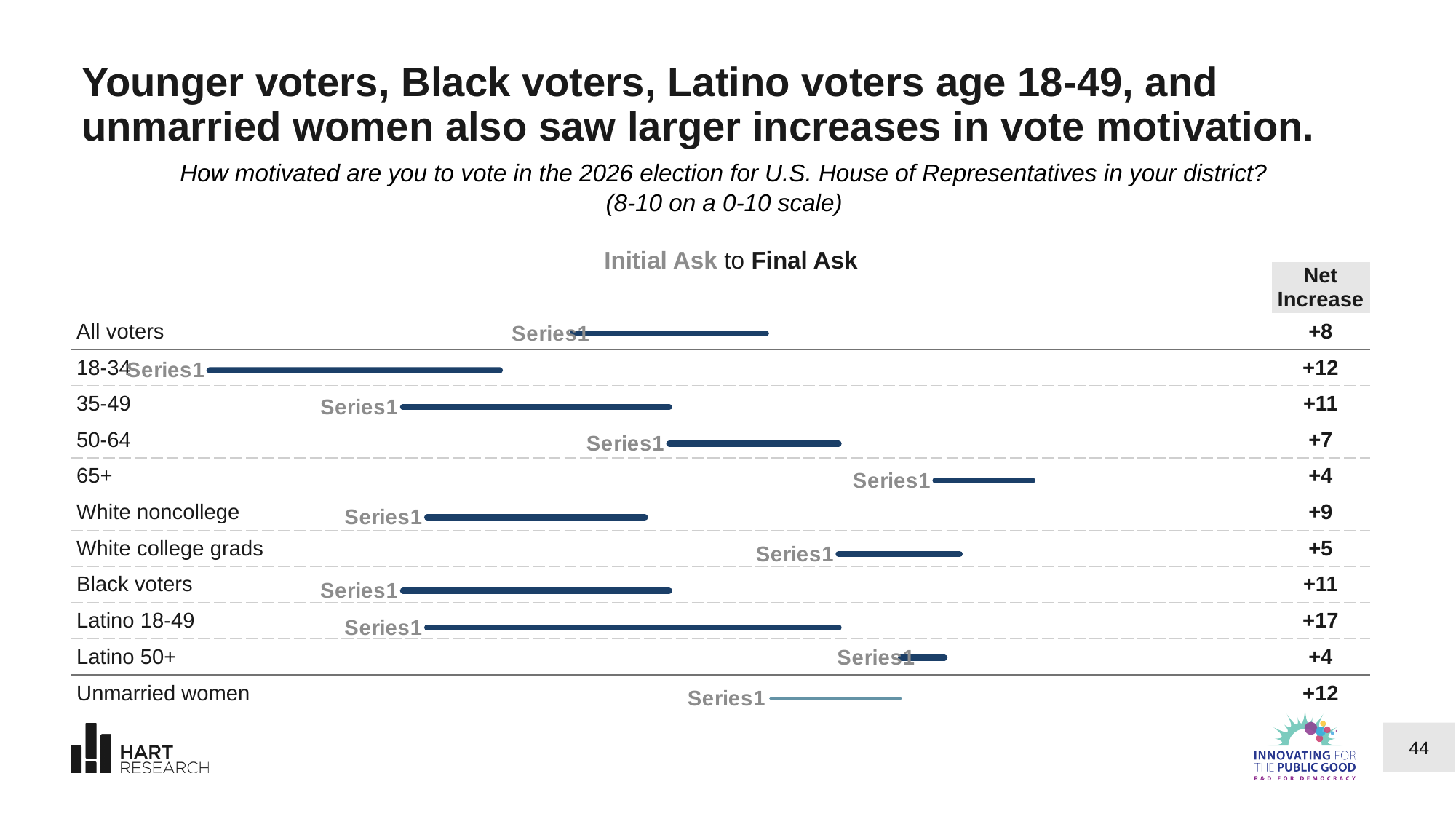
What is the net increase shown for Unmarried women? +12 How much larger is the net increase for Latino 18-49 than for All voters? 9 Which has a larger net increase, Black voters or White college grads? Black voters What is the net increase shown for voters age 50-64? +7 Which groups have the smallest net increase in vote motivation? 65+ and Latino 50+ What is the difference between the net increase for 18-34 and for 65+? 8 What is the net increase in vote motivation for All voters? +8 How many voter groups are listed in the chart? 11 Which group has the largest net increase in vote motivation? Latino 18-49 What two points does the chart header say each line runs between? Initial Ask to Final Ask What is the net increase shown for Latino 18-49? +17 What is the net increase shown for White college grads? +5